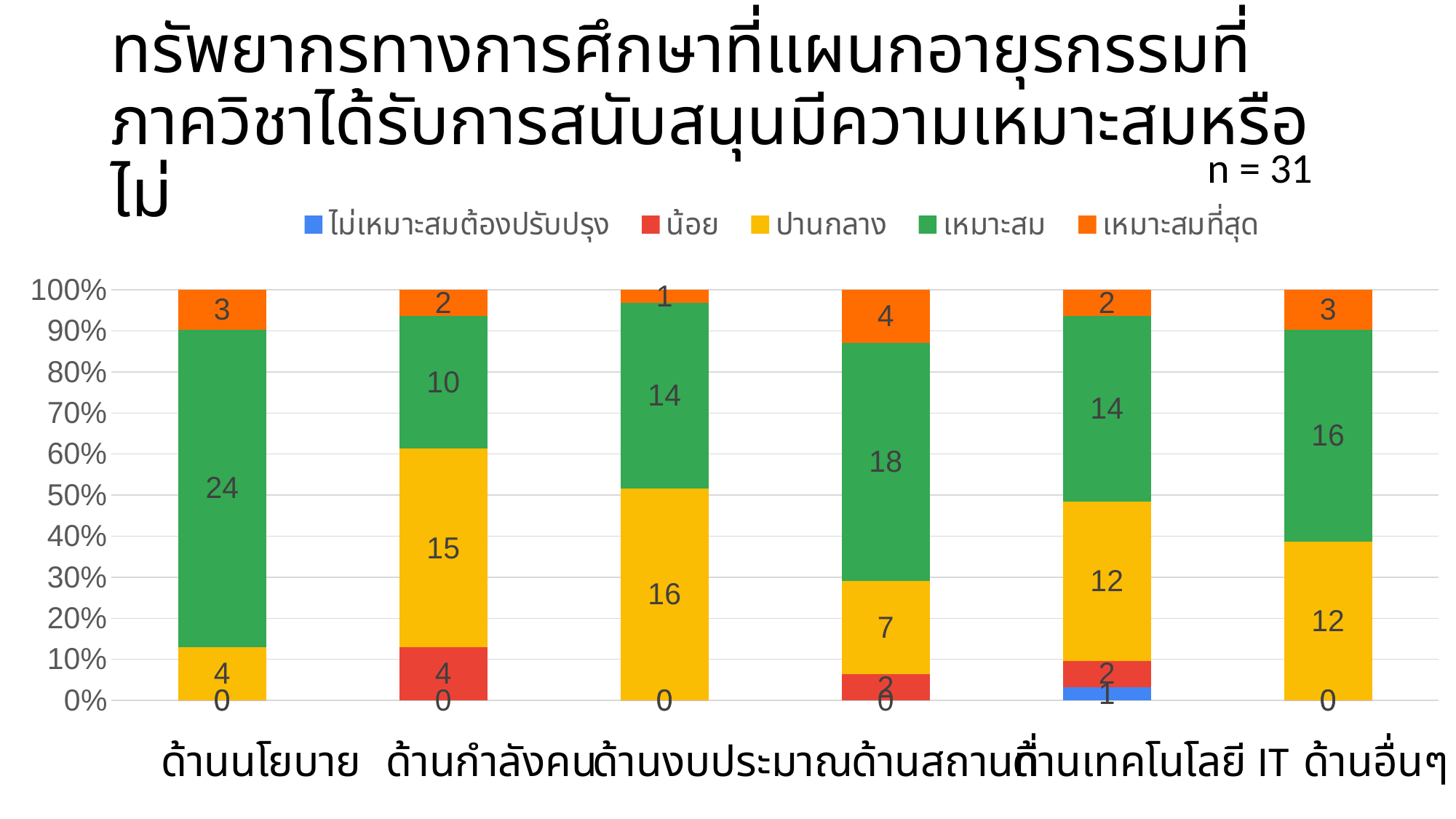
What sample size (n) is stated on the slide? n = 31 What is the value of the เหมาะสมที่สุด series for ด้านงบประมาณ? 1 What is the value of the ปานกลาง series for ด้านกำลังคน? 15 What kind of chart is shown on the slide? Stacked bar chart How many categories are shown on the x axis? 6 Which category has the highest value for the เหมาะสม series? ด้านนโยบาย Which category has the lowest value for the เหมาะสมที่สุด series? ด้านงบประมาณ What is the difference between the ปานกลาง values for ด้านงบประมาณ and ด้านอื่นๆ? 4 Which has the larger เหมาะสม value, ด้านสถานที่ or ด้านเทคโนโลยี IT? ด้านสถานที่ What is the value of the ไม่เหมาะสมต้องปรับปรุง series for ด้านเทคโนโลยี IT? 1 What is the value of the เหมาะสม series for ด้านนโยบาย? 24 How many series does the legend list? 5